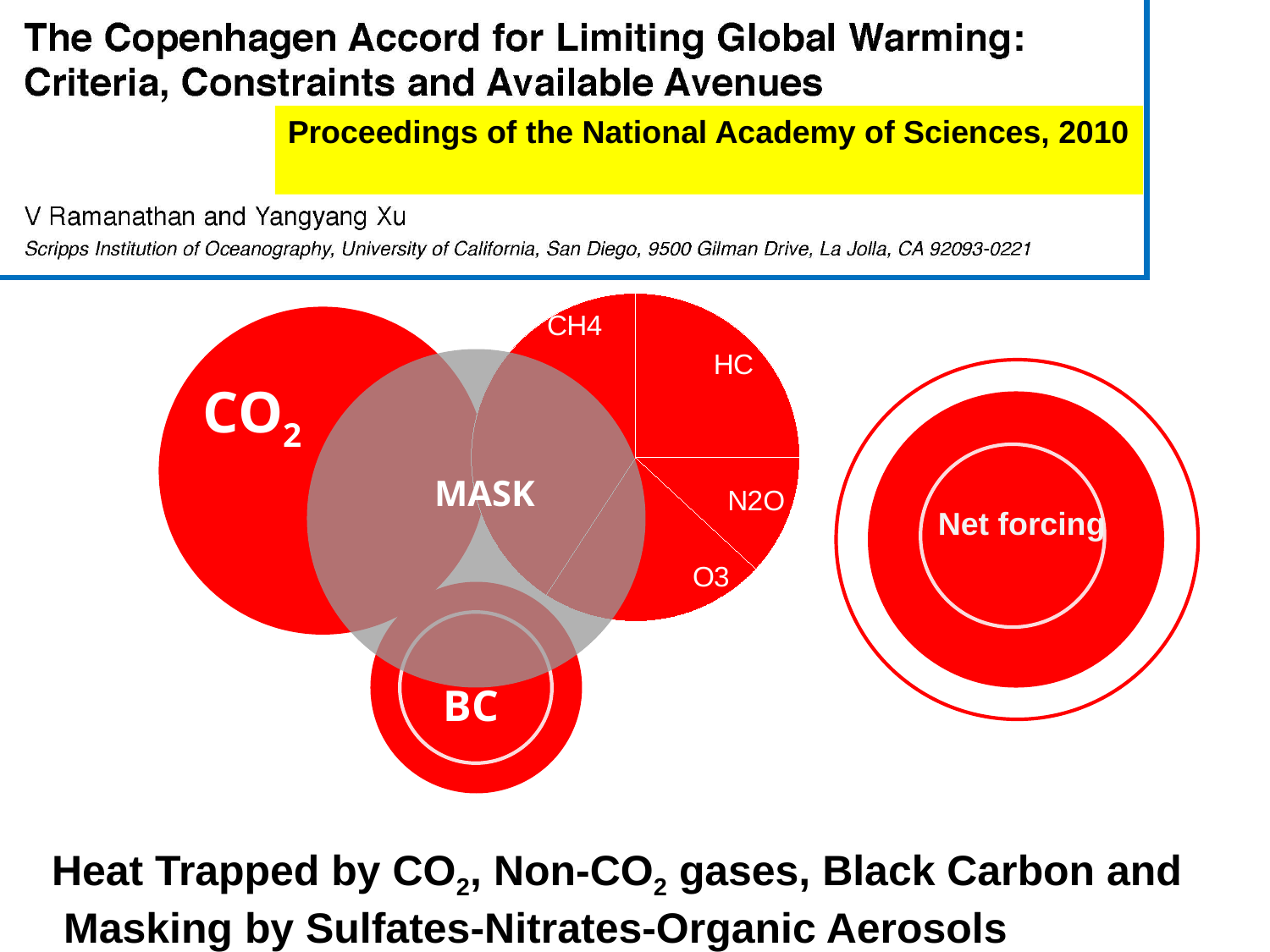
In the non-CO2 gases pie chart, which slice is larger, HC or N2O? HC Which circle in the diagram is larger, the CO2 circle or the BC circle? CO2 What kind of chart is used to show the non-CO2 gases (CH4, HC, N2O, O3)? pie chart How many slices does the non-CO2 gases pie chart have? 4 In the non-CO2 gases pie chart, which slice is larger, CH4 or HC? CH4 What label is written in the grey overlapping circle in the diagram? MASK Which slice of the non-CO2 gases pie chart is the smallest? N2O Which slice of the non-CO2 gases pie chart is the largest? CH4 What label is written in the circle on the right side of the diagram? Net forcing